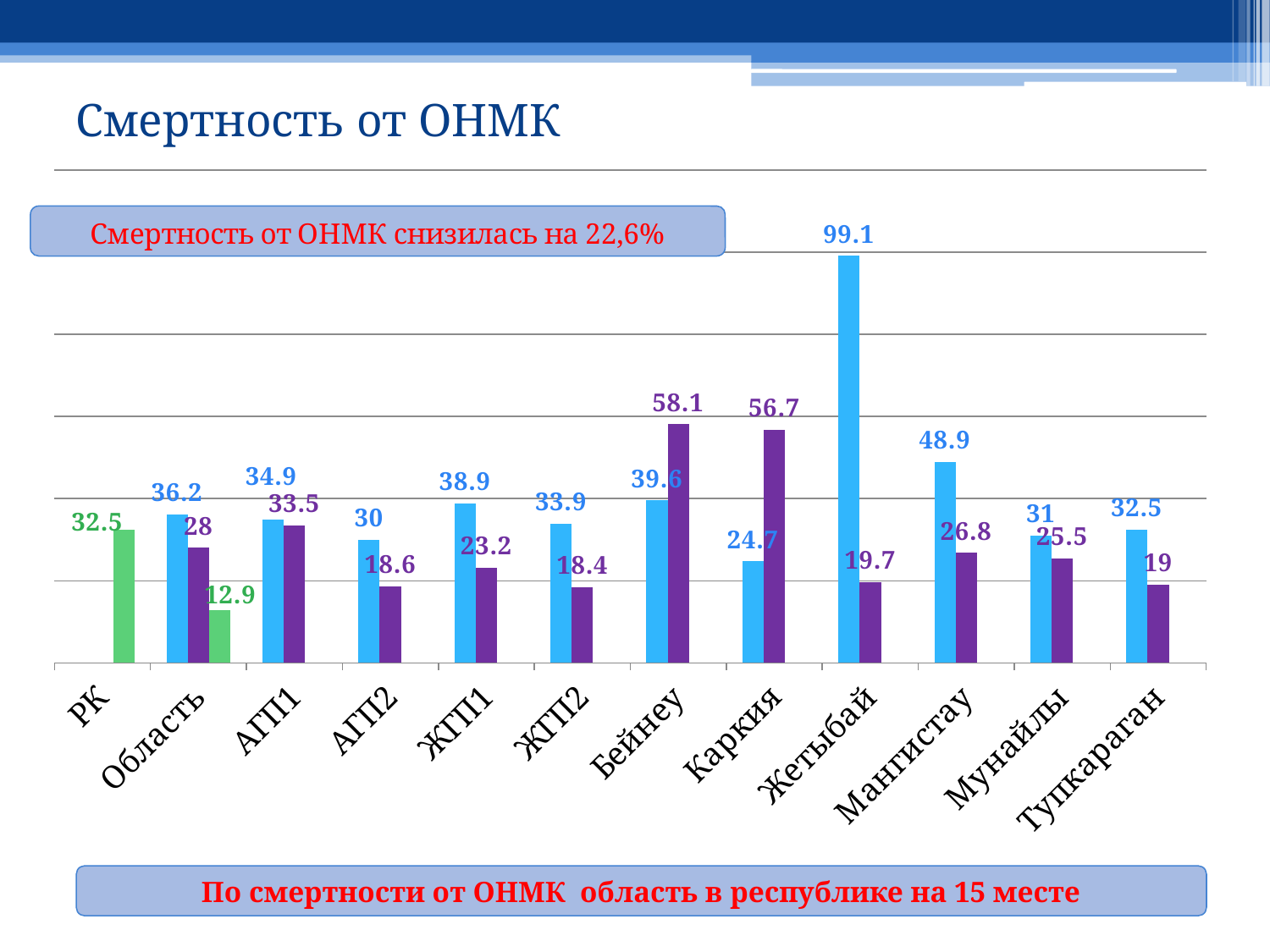
What type of chart is shown on the slide? bar chart What is the title of the chart on the slide? Смертность от ОНМК What is the value of the purple bar for Бейнеу? 58.1 Which category has the lowest purple bar? ЖГП2 How many categories are shown on the x axis of the chart? 12 Which category has the highest light blue bar? Жетыбай What is the difference between the light blue and purple bars for Жетыбай? 79.4 What is the difference between the light blue bar for Мангистау and the light blue bar for Мунайлы? 17.9 What is the value of the light blue bar for Жетыбай? 99.1 What is the value of the green bar for РК? 32.5 What is the value of the purple bar for Область? 28 Which is larger for Каркия, the light blue bar or the purple bar? the purple bar